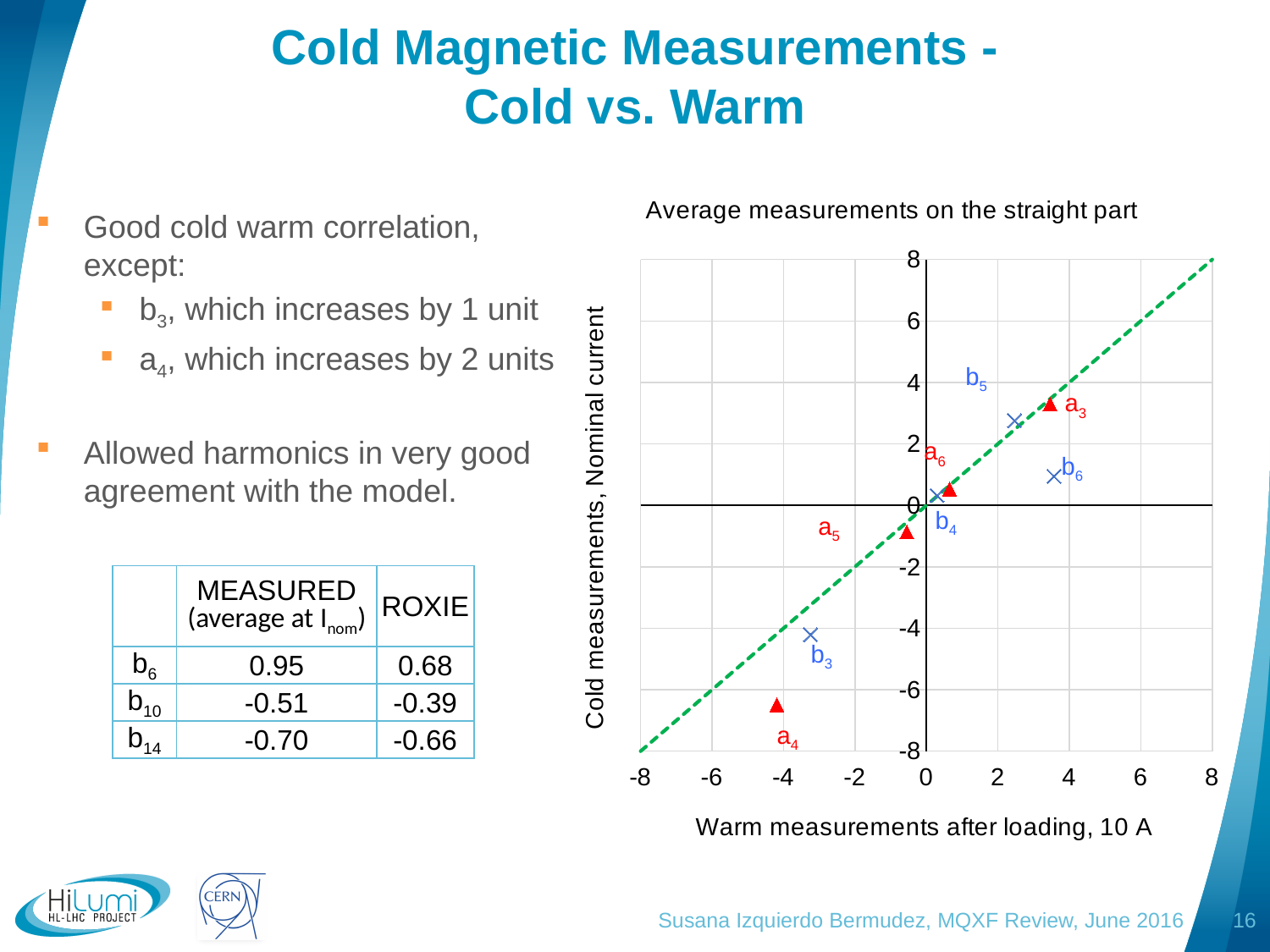
What kind of chart is shown on the slide? Scatter chart Which has the higher cold measurement value, b5 or b6? b5 Which labelled point has the lowest cold measurement value on the chart? a4 What is the title of the chart? Average measurements on the straight part Is the cold measurement value for a4 greater or less than -4? less Is the cold measurement value for a3 greater or less than 2? greater Which labelled point has the highest cold measurement value on the chart? a3 Which labelled point has the lowest warm measurement value on the chart? a4 Is the warm measurement value for b6 greater or less than 2? greater How many labelled data points are plotted on the chart? 8 What is the label of the horizontal axis of the chart? Warm measurements after loading, 10 A